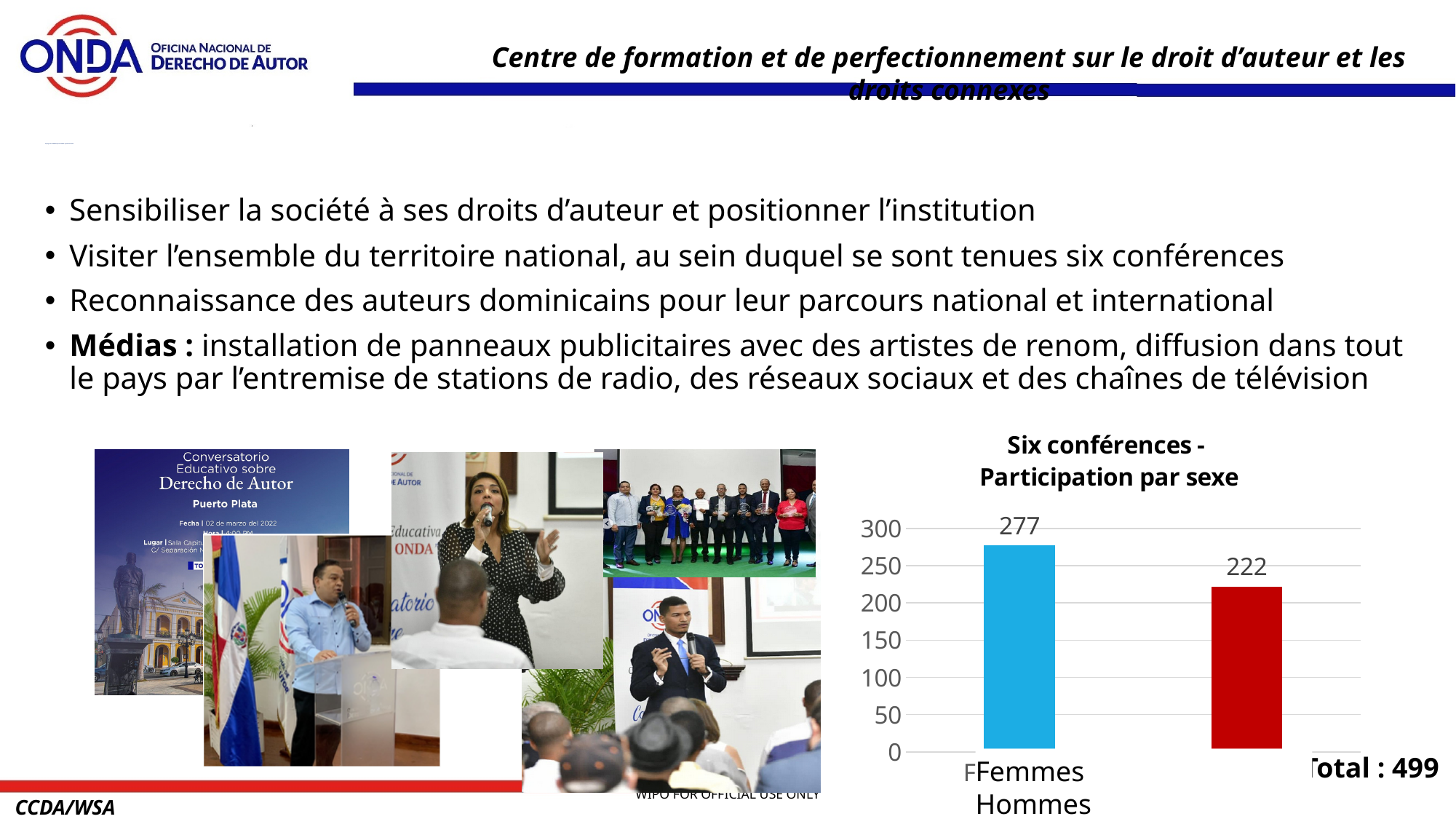
What is the difference between the values for Femmes and Hommes? 55 Is the value for Hommes greater or less than 250? less Is the value for Femmes greater or less than 250? greater How many categories are shown in the chart? 2 What is the value for Hommes in the chart? 222 Which category has the highest value in the chart? Femmes What is the total of the two values shown in the chart? 499 What kind of chart is shown on the slide? bar chart What is the title of the chart? Six conférences - Participation par sexe Which category has the lowest value in the chart? Hommes Which is larger, the value for Femmes or the value for Hommes? Femmes What is the value for Femmes in the chart? 277